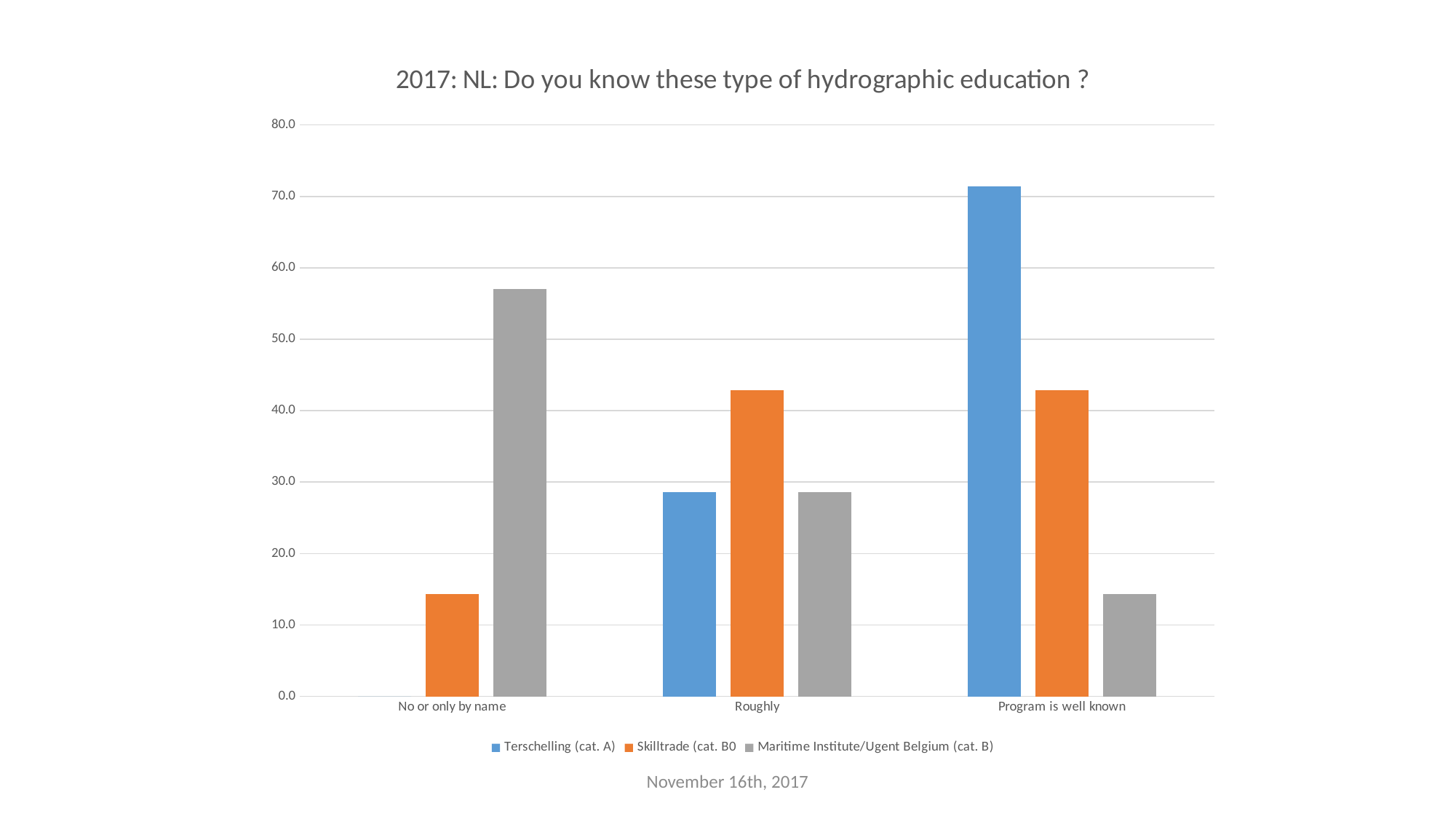
Is the value for Skilltrade (cat. B0 at 'Roughly' greater or less than 40? greater What kind of chart is shown on the slide? bar chart Is the value for Terschelling (cat. A) at 'Program is well known' greater or less than 70? greater How many series does the legend list? 3 What is the title of the chart? 2017: NL: Do you know these type of hydrographic education ? Which series is shown in orange in the legend? Skilltrade (cat. B0 Is the value for Maritime Institute/Ugent Belgium (cat. B) at 'No or only by name' greater or less than 50? greater For the Maritime Institute/Ugent Belgium (cat. B) series, which category has the lowest value? Program is well known How many categories are shown on the x axis? 3 For the Terschelling (cat. A) series, which category has the highest value? Program is well known At 'No or only by name', which is larger: Skilltrade (cat. B0 or Maritime Institute/Ugent Belgium (cat. B)? Maritime Institute/Ugent Belgium (cat. B)